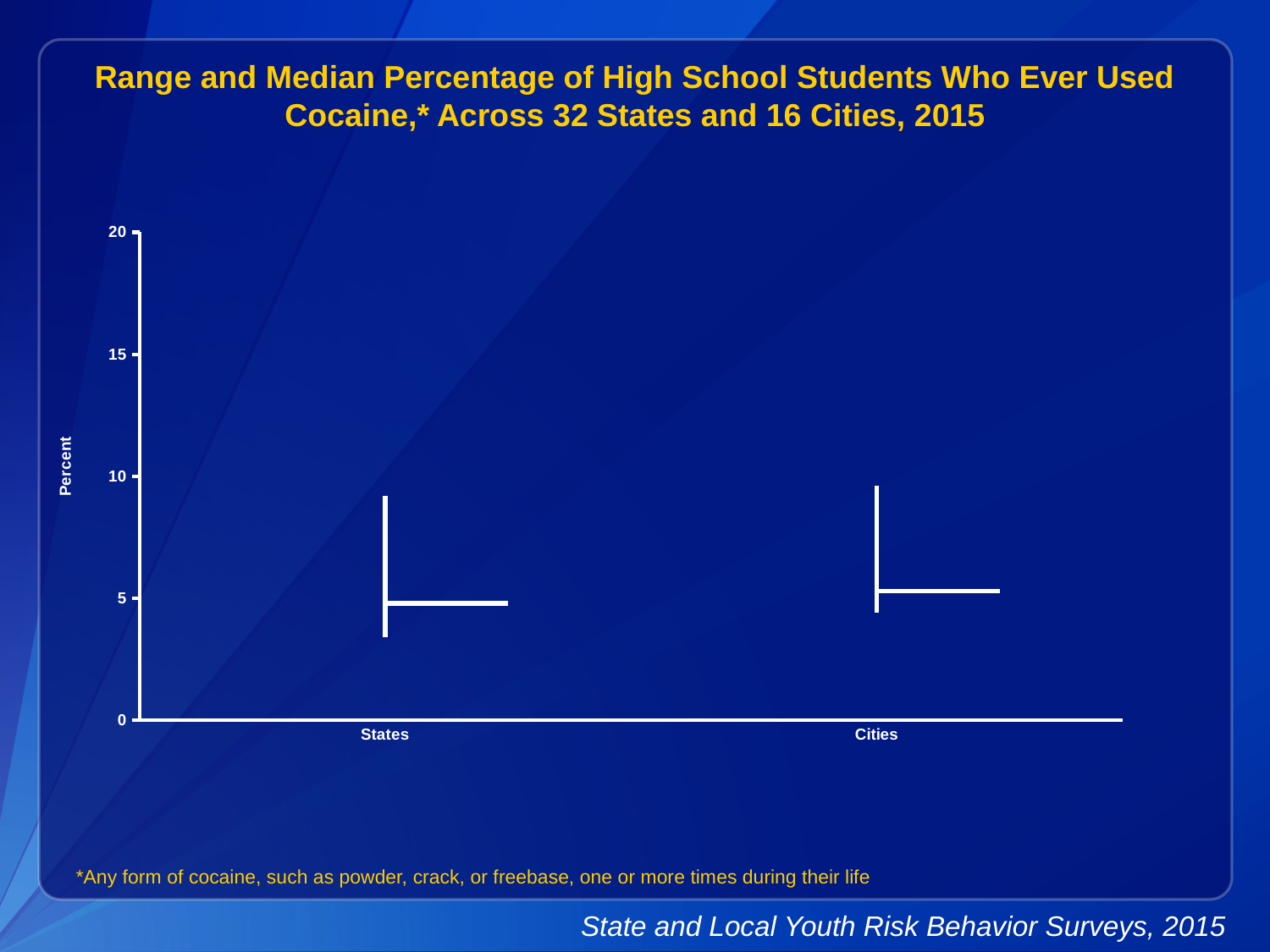
Is the median for States greater or less than 10? less Is the top of the range for Cities greater or less than 10? less What are the two categories shown on the x axis? States and Cities Which category has the higher median, States or Cities? Cities Is the top of the range for States greater or less than 10? less How many categories are shown on the x axis of the chart? 2 Does the chart show a range and median for each category, or a single bar? A range and median Which category has the lower bottom of its range, States or Cities? States What is the label on the y axis of the chart? Percent What is the highest value shown on the y axis? 20